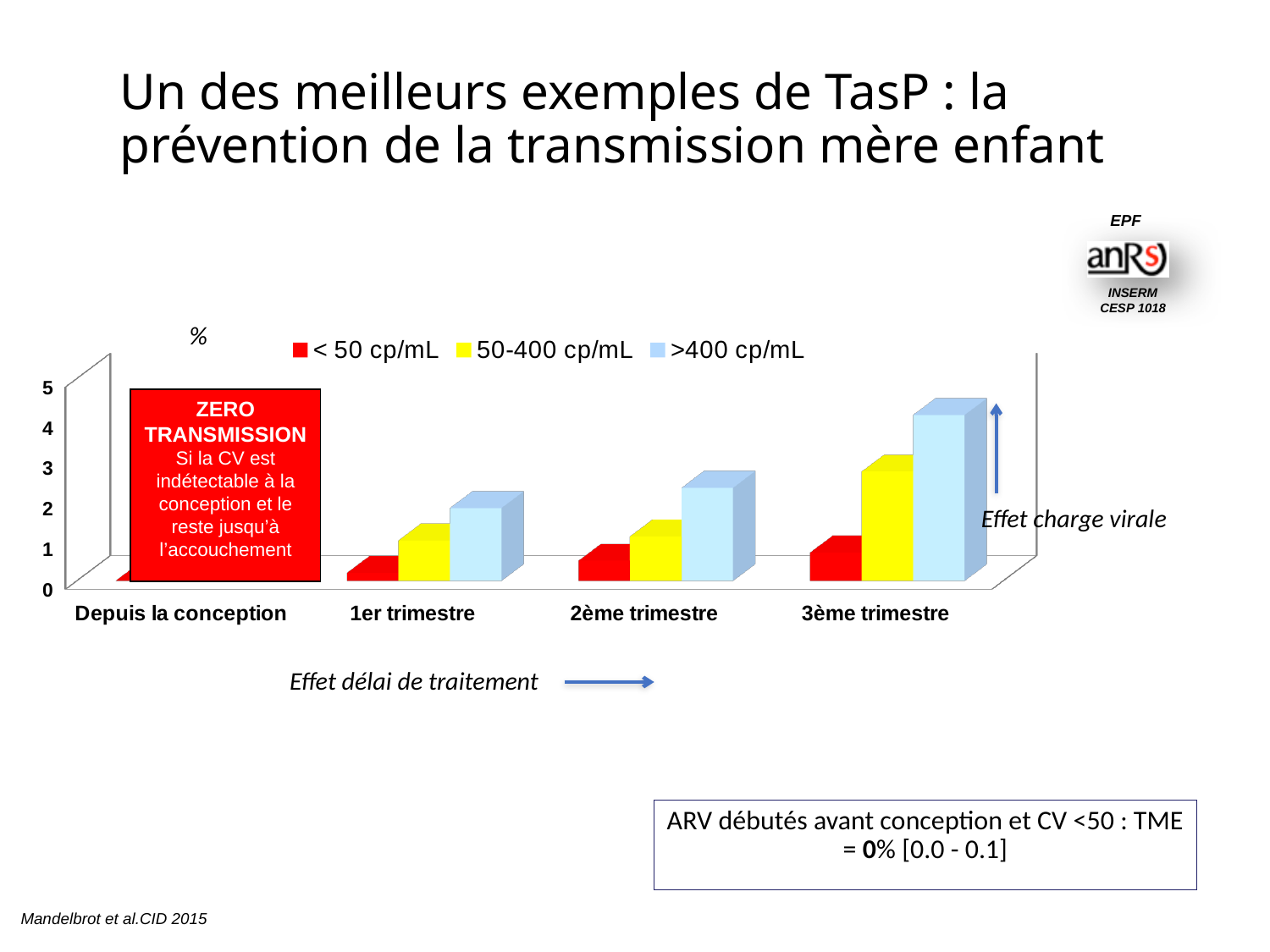
How many series does the chart legend list? 3 What unit is indicated on the y axis of the chart? % How many categories are shown along the x axis of the chart? 4 Is the value for 50-400 cp/mL in the 3ème trimestre category greater or less than 1? greater Is the value for >400 cp/mL in the 3ème trimestre category greater or less than 3? greater Which is larger: the >400 cp/mL value for 1er trimestre or for 3ème trimestre? 3ème trimestre In the 2ème trimestre category, which series has the lowest bar? < 50 cp/mL What are the three series listed in the chart legend? < 50 cp/mL, 50-400 cp/mL, >400 cp/mL In the 3ème trimestre category, which series has the highest bar? >400 cp/mL Is the value for >400 cp/mL in the 1er trimestre category greater or less than 3? less What kind of chart is shown on the slide? bar chart